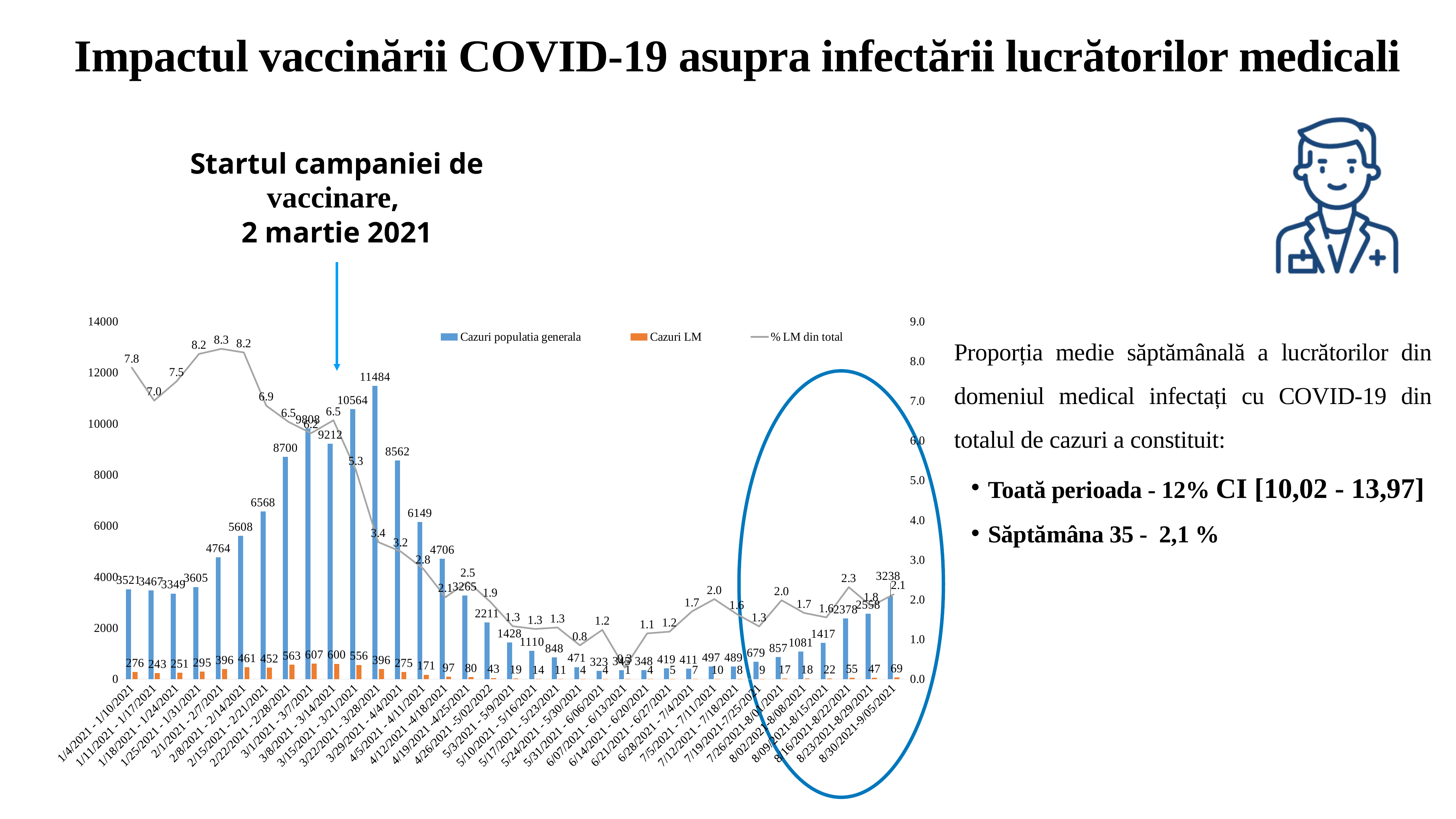
What is the difference between Cazuri populatia generala for 3/22/2021 - 3/28/2021 and for 3/15/2021 - 3/21/2021? 920 Which week has the lowest value of Cazuri LM? 6/07/2021 - 6/13/2021 How many weekly categories are shown on the x axis? 35 What is the value of Cazuri LM for the week 3/1/2021 - 3/7/2021? 607 How many series does the legend list? 3 Which week has the highest value of Cazuri populatia generala? 3/22/2021 - 3/28/2021 What is the value of Cazuri populatia generala for the week 3/22/2021 - 3/28/2021? 11484 What is the % LM din total value for the week 8/30/2021 - 9/05/2021? 2.1 Which is larger: Cazuri LM for 8/16/2021 - 8/22/2021 or for 8/23/2021 - 8/29/2021? 8/16/2021-8/22/2021 Does the % LM din total line rise or fall from 2/1/2021 - 2/7/2021 to 6/07/2021 - 6/13/2021? Fall What kind of chart is this? Combined bar and line chart Which week has the highest % LM din total value? 2/1/2021 - 2/7/2021